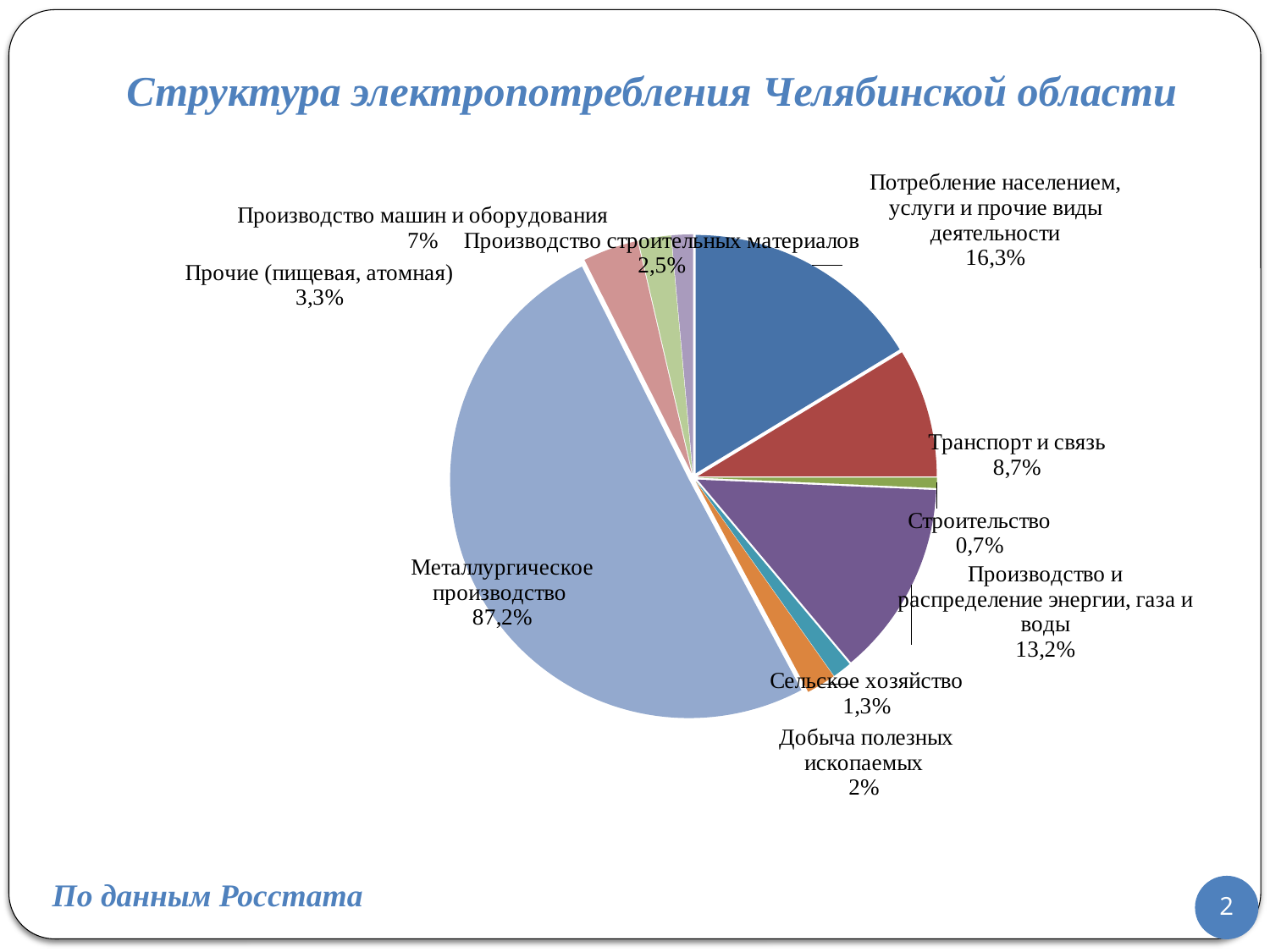
What kind of chart is shown on the slide? Pie chart What share is shown for Транспорт и связь? 8,7% Which category has the largest slice of the pie? Металлургическое производство What share is shown for Потребление населением, услуги и прочие виды деятельности? 16,3% What share is shown for Сельское хозяйство? 1,3% Which is larger: Транспорт и связь or Производство машин и оборудования? Транспорт и связь How many categories (slices) does the pie chart have? 10 What share is shown for Производство и распределение энергии, газа и воды? 13,2% What share is shown for Металлургическое производство? 87,2% Which category has the smallest slice of the pie? Строительство What is the title of the chart on the slide? Структура электропотребления Челябинской области What is the difference between the shares of Потребление населением, услуги и прочие виды деятельности and Производство и распределение энергии, газа и воды? 3,1%